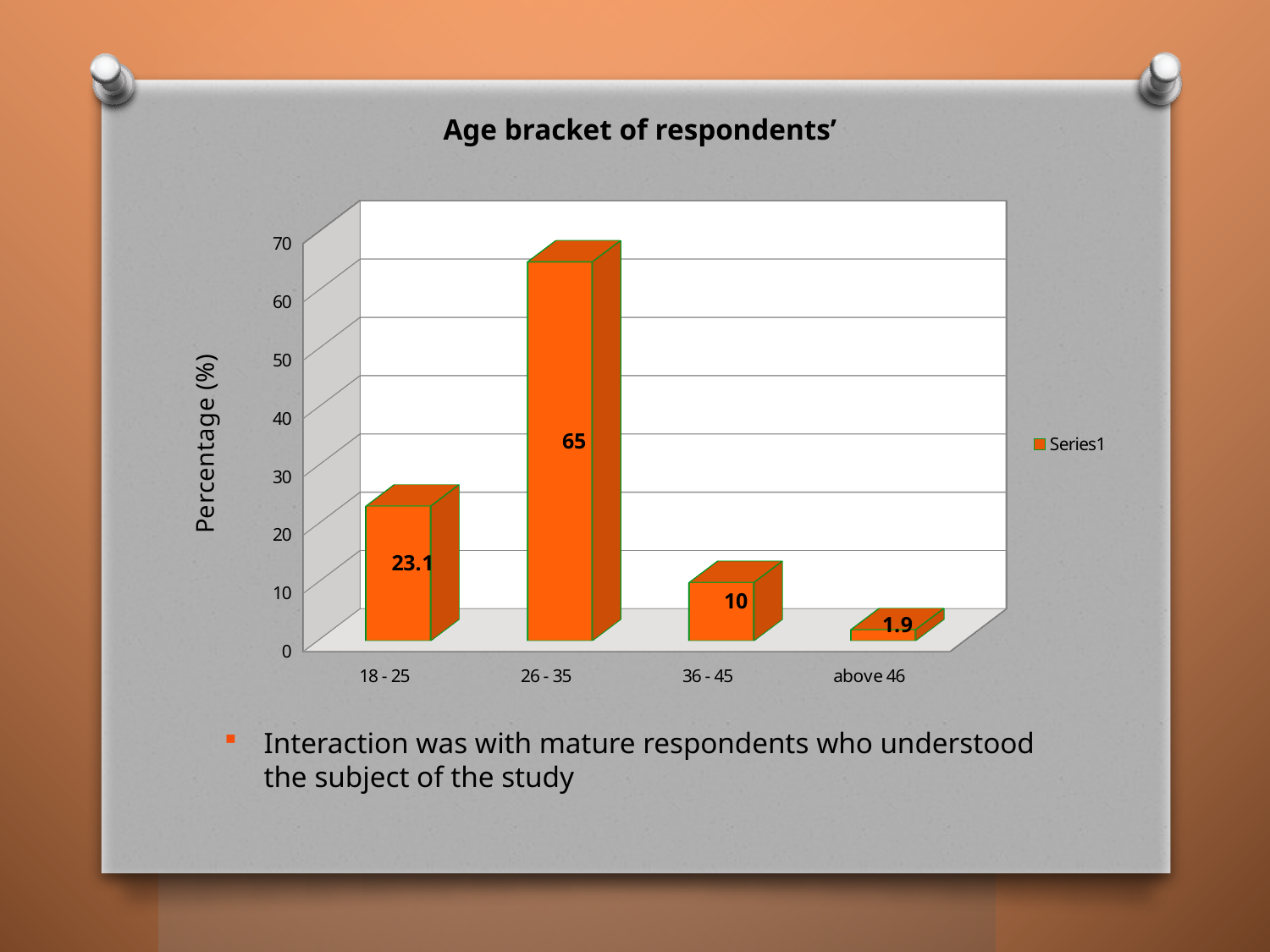
What is the difference between the values for 26 - 35 and 18 - 25? 41.9 What is the title of the chart? Age bracket of respondents' Which age bracket has the lowest percentage? above 46 What is the value for the above 46 age bracket? 1.9 What is the value for the 18 - 25 age bracket? 23.1 What kind of chart is shown on the slide? bar chart How many age brackets are shown on the x axis? 4 What is the value for the 36 - 45 age bracket? 10 Is the value for 26 - 35 greater or less than 60? greater Which age bracket has the highest percentage? 26 - 35 What is the value for the 26 - 35 age bracket? 65 Which is larger, the value for 18 - 25 or the value for 36 - 45? 18 - 25